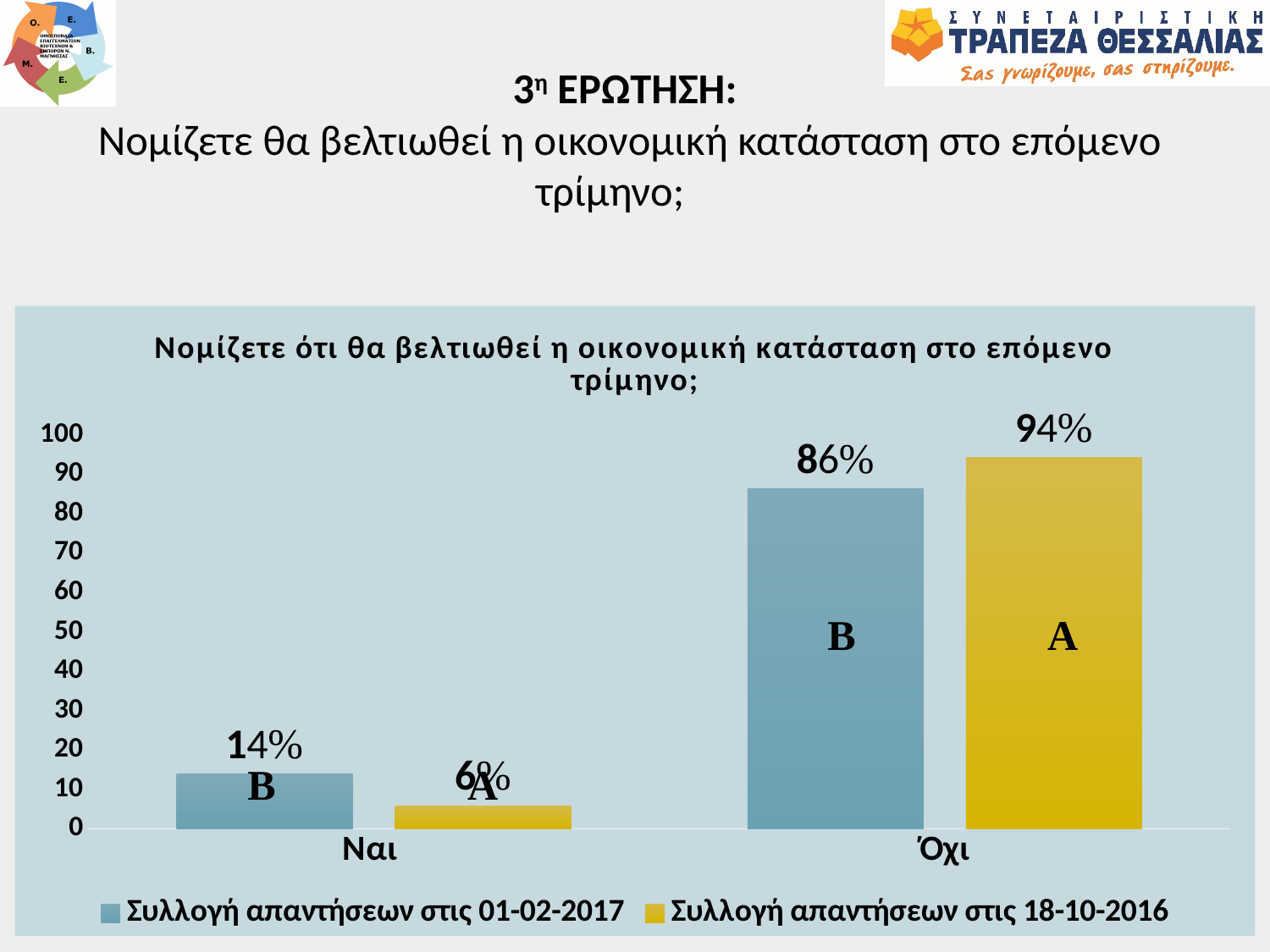
For the category Ναι, which series has the larger value? Συλλογή απαντήσεων στις 01-02-2017 Which category has the lowest value in the series Συλλογή απαντήσεων στις 01-02-2017? Ναι How many series does the legend list? 2 What is the value for Ναι in the series Συλλογή απαντήσεων στις 01-02-2017? 14% What is the value for Όχι in the series Συλλογή απαντήσεων στις 01-02-2017? 86% What colour are the bars for the series Συλλογή απαντήσεων στις 18-10-2016? yellow What type of chart is shown on the slide? bar chart What is the difference between the Όχι values of the two series (94% and 86%)? 8% How many categories are shown on the x axis? 2 What is the value for Ναι in the series Συλλογή απαντήσεων στις 18-10-2016? 6% What is the value for Όχι in the series Συλλογή απαντήσεων στις 18-10-2016? 94% Which category has the highest value in the series Συλλογή απαντήσεων στις 18-10-2016? Όχι